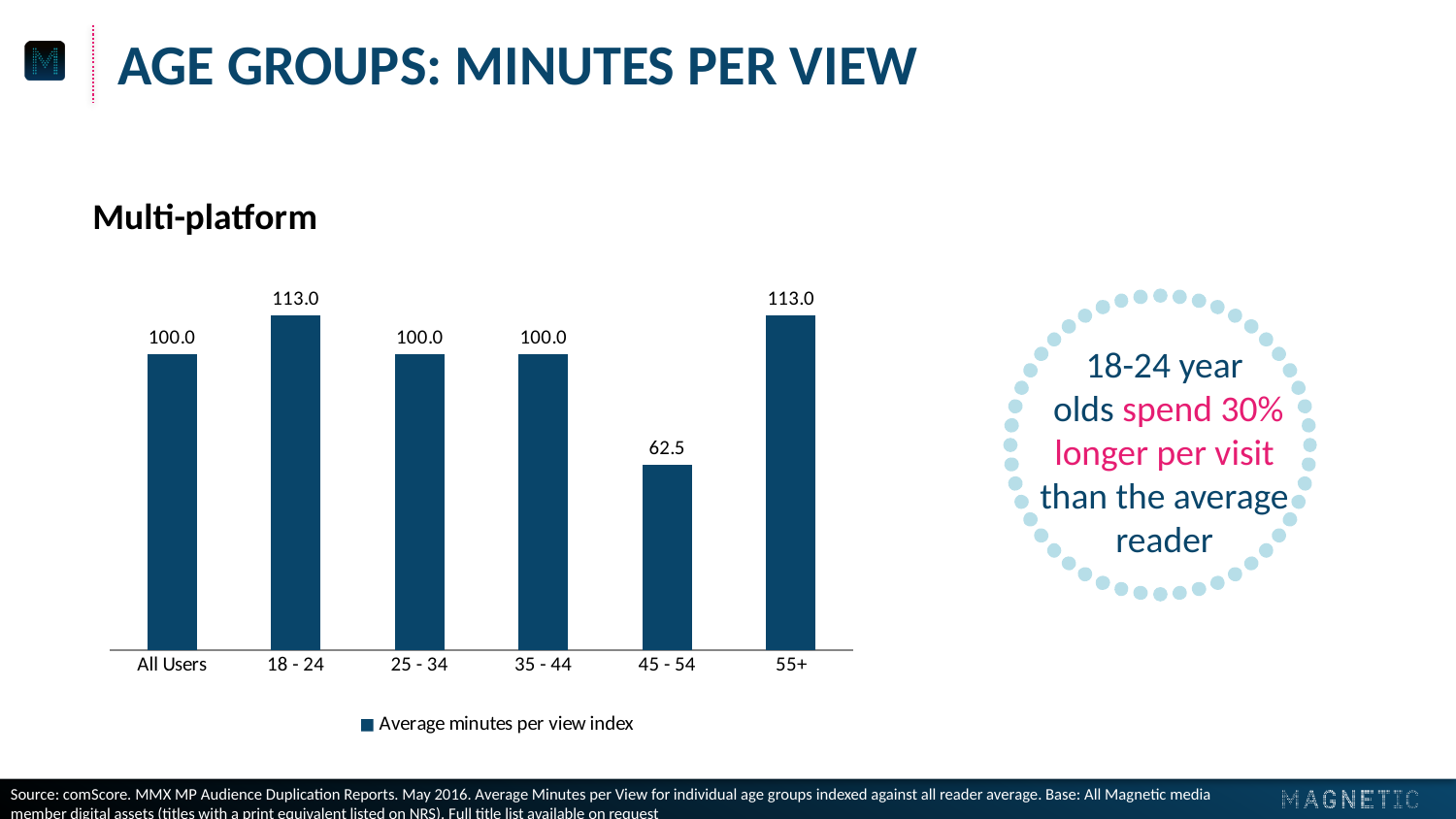
Which is larger, the index for 25 - 34 or the index for 45 - 54? 25 - 34 What is the heading shown above the chart? Multi-platform What kind of chart is shown on the slide? Bar chart How many series does the chart legend list? 1 What is the average minutes per view index for the 45 - 54 age group? 62.5 What is the difference between the index for 18 - 24 and the index for All Users? 13.0 What is the average minutes per view index for the 18 - 24 age group? 113.0 What is the difference between the index for 55+ and the index for 45 - 54? 50.5 What is the average minutes per view index for All Users? 100.0 Which age group has the lowest average minutes per view index? 45 - 54 How many categories are shown on the x axis of the chart? 6 What is the legend entry for the series in the chart? Average minutes per view index